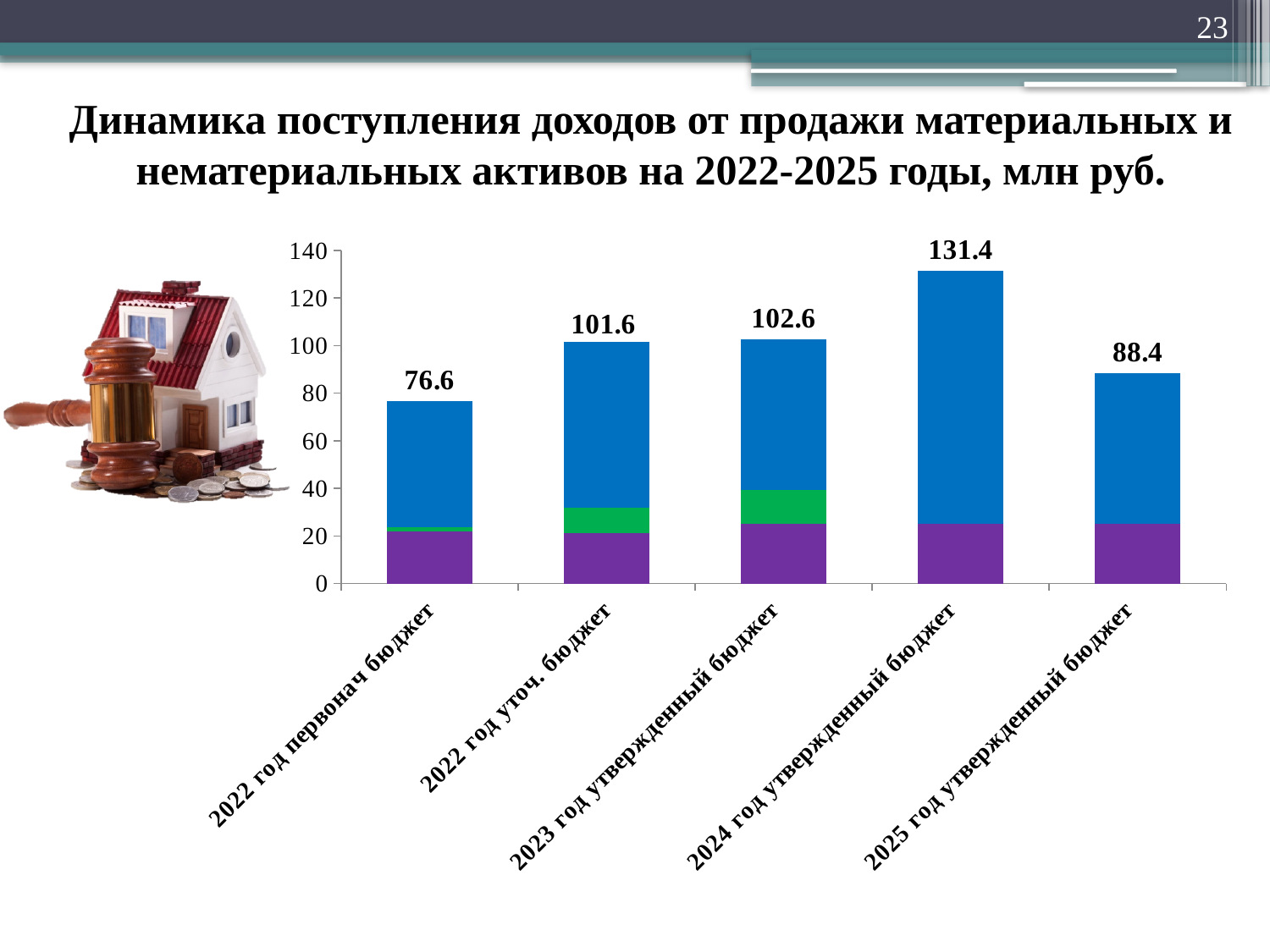
Which category has the lowest total value? 2022 год первонач бюджет Does the total value rise or fall from "2024 год утвержденный бюджет" to "2025 год утвержденный бюджет"? fall Is the total for "2024 год утвержденный бюджет" greater or less than 120? greater What kind of chart is shown on the slide? Stacked bar chart What is the difference between the totals for "2024 год утвержденный бюджет" and "2022 год первонач бюджет"? 54.8 How many categories are shown on the x axis? 5 Which category has the highest total value? 2024 год утвержденный бюджет What is the total value labelled for the bar "2024 год утвержденный бюджет"? 131.4 What is the total value labelled for the bar "2025 год утвержденный бюджет"? 88.4 Which is larger: the total for "2025 год утвержденный бюджет" or for "2022 год первонач бюджет"? 2025 год утвержденный бюджет What is the difference between the totals for "2023 год утвержденный бюджет" and "2022 год уточ. бюджет"? 1.0 What is the total value labelled for the bar "2022 год первонач бюджет"? 76.6